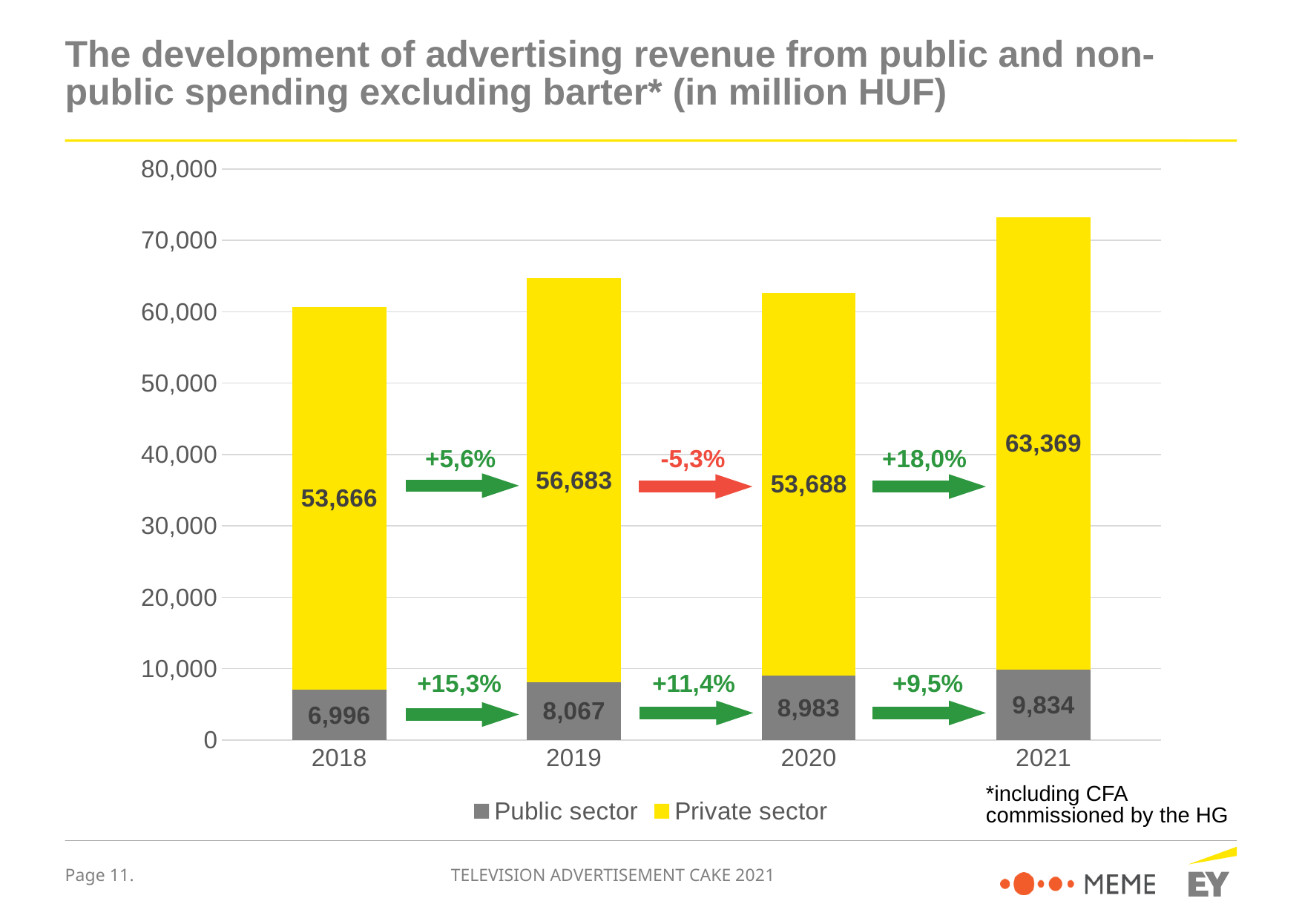
What kind of chart is shown on the slide? Stacked bar chart Which year has the lowest Public sector value? 2018 What is the Private sector value for 2021? 63,369 What is the Private sector value for 2020? 53,688 What is the total of the stacked bar for 2021? 73,203 What is the total of the stacked bar for 2018? 60,662 What is the difference between the Private sector values for 2021 and 2020? 9,681 Which is larger, the Private sector value for 2019 or for 2020? 2019 How many years are shown on the x axis? 4 Which year has the highest Private sector value? 2021 What is the Public sector value for 2018? 6,996 How many series does the legend list? 2